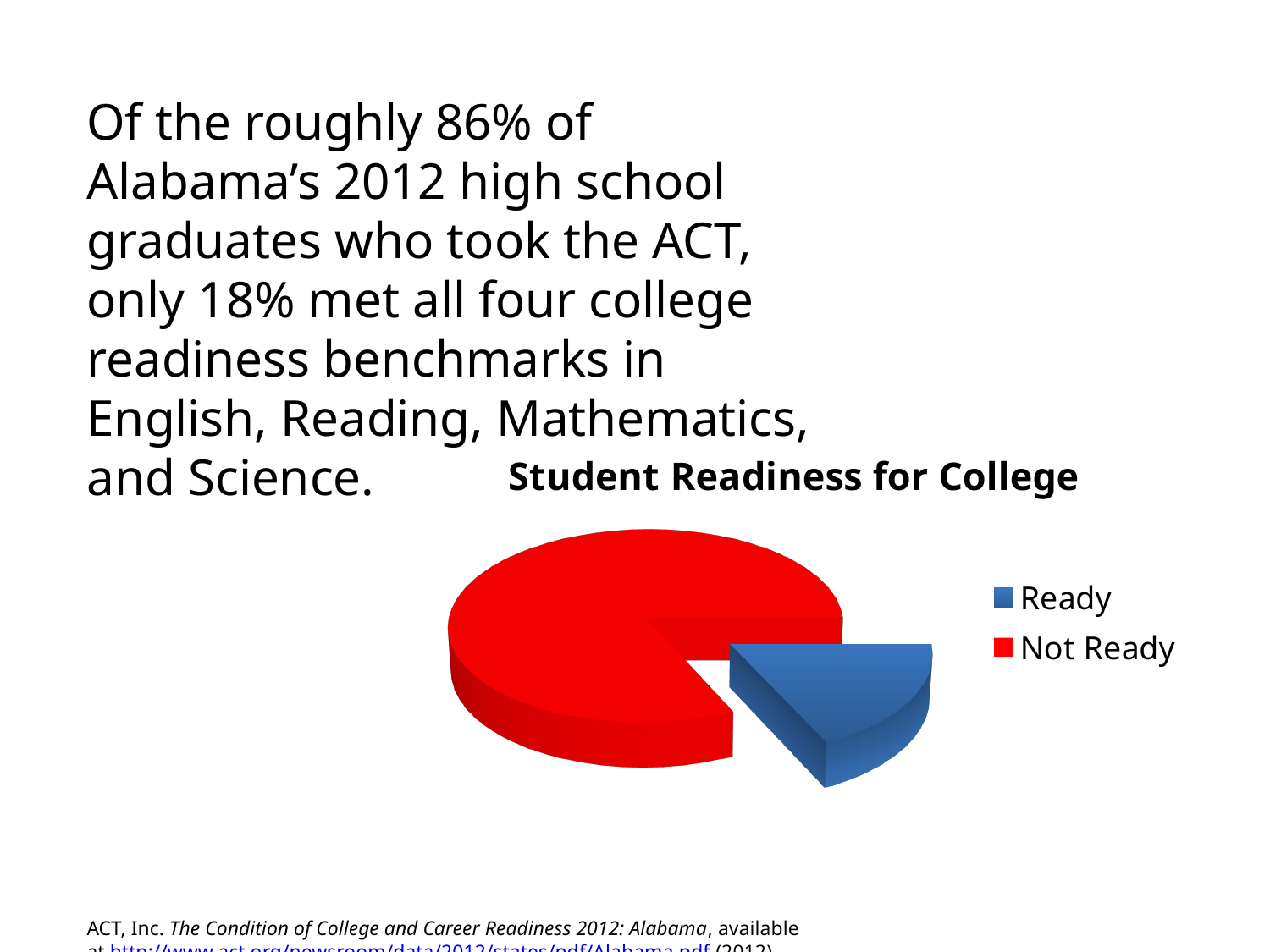
Which category has the smallest slice of the pie? Ready How many entries does the chart's legend list? 2 How many slices does the pie chart have? 2 What is the title of the chart? Student Readiness for College What colour is the Ready slice in the pie chart? blue Which slice is larger, Ready or Not Ready? Not Ready Which category has the largest slice of the pie? Not Ready What kind of chart is shown on the slide? pie chart Which category is shown in red in the pie chart? Not Ready